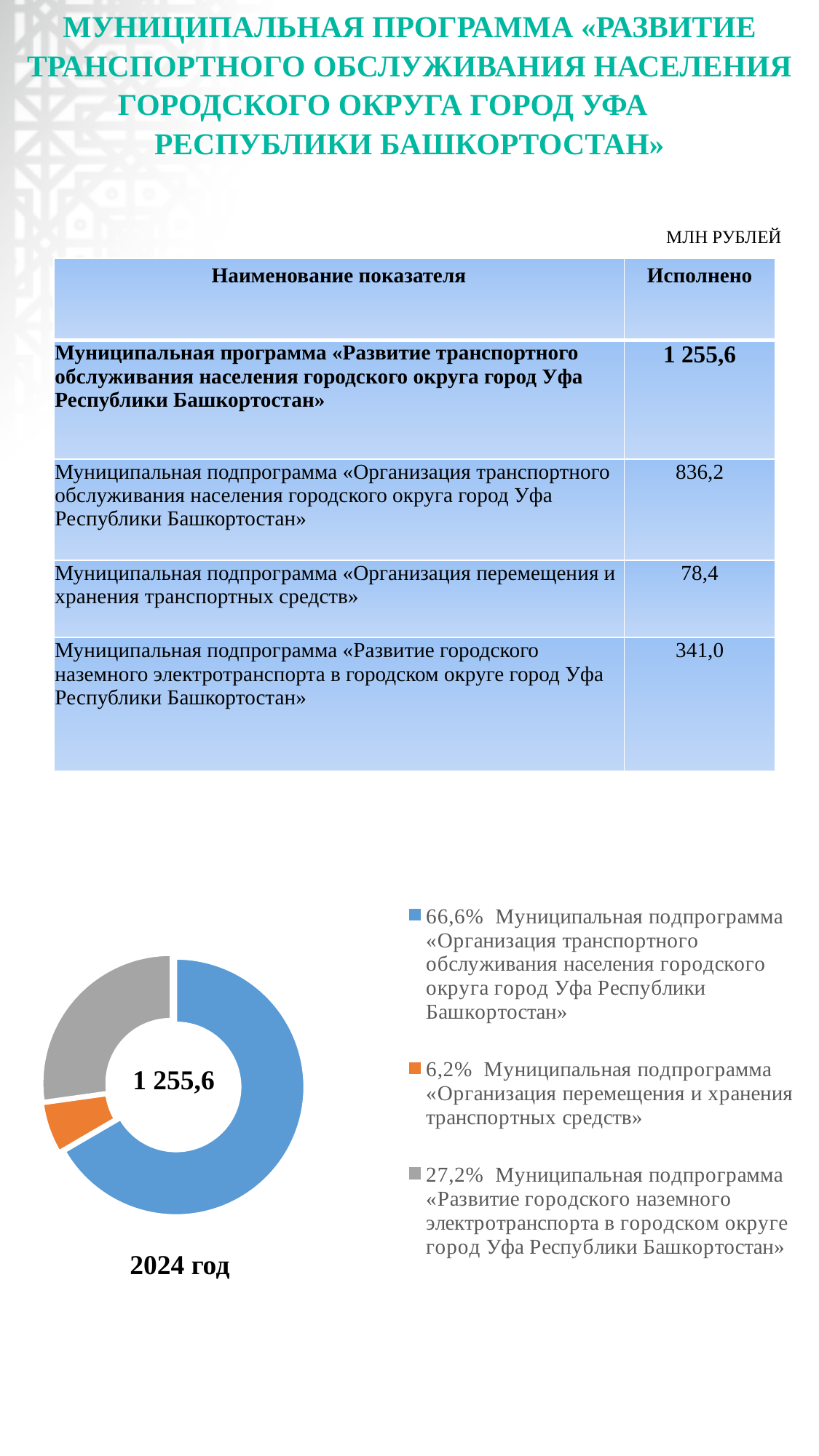
What total value is printed in the centre of the doughnut chart? 1 255,6 What share of the doughnut chart belongs to the subprogram «Организация перемещения и хранения транспортных средств»? 6,2% How many slices does the doughnut chart have? 3 How many entries does the legend of the doughnut chart list? 3 What is the difference in percentage points between the 66,6% slice and the 27,2% slice in the doughnut chart? 39,4 What share of the doughnut chart belongs to the subprogram «Развитие городского наземного электротранспорта в городском округе город Уфа Республики Башкортостан»? 27,2% What kind of chart is shown at the bottom of the slide? Doughnut (pie) chart Which subprogram has the largest slice in the doughnut chart? Муниципальная подпрограмма «Организация транспортного обслуживания населения городского округа город Уфа Республики Башкортостан» In the doughnut chart, which slice is larger: the one for «Развитие городского наземного электротранспорта...» or the one for «Организация перемещения и хранения транспортных средств»? «Развитие городского наземного электротранспорта...» What share of the doughnut chart belongs to the subprogram «Организация транспортного обслуживания населения городского округа город Уфа Республики Башкортостан»? 66,6% Which year is labelled under the doughnut chart? 2024 год Which subprogram has the smallest slice in the doughnut chart? Муниципальная подпрограмма «Организация перемещения и хранения транспортных средств»